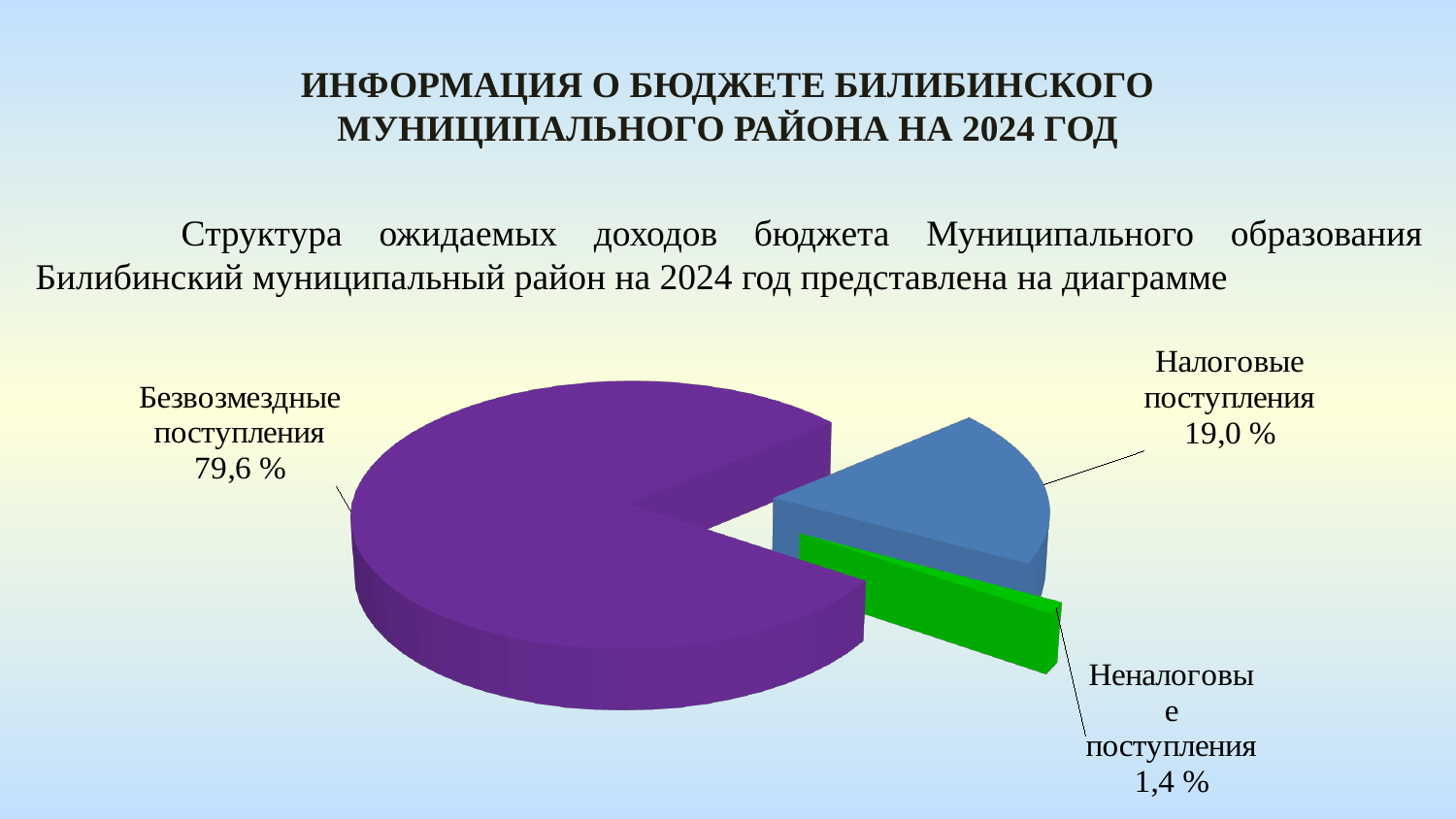
What is the difference in percentage points between Налоговые поступления and Неналоговые поступления? 17,6 What is the difference in percentage points between Безвозмездные поступления and Налоговые поступления? 60,6 Which category has the largest slice of the pie? Безвозмездные поступления How many categories (slices) does the pie chart show? 3 What colour is the slice for Неналоговые поступления? Green What share of the pie is labelled for Неналоговые поступления? 1,4 % What share of the pie is labelled for Налоговые поступления? 19,0 % Which is larger: the share for Налоговые поступления or the share for Неналоговые поступления? Налоговые поступления What colour is the slice for Налоговые поступления? Blue What kind of chart is shown on the slide? Pie chart What share of the pie is labelled for Безвозмездные поступления? 79,6 % Which category has the smallest slice of the pie? Неналоговые поступления